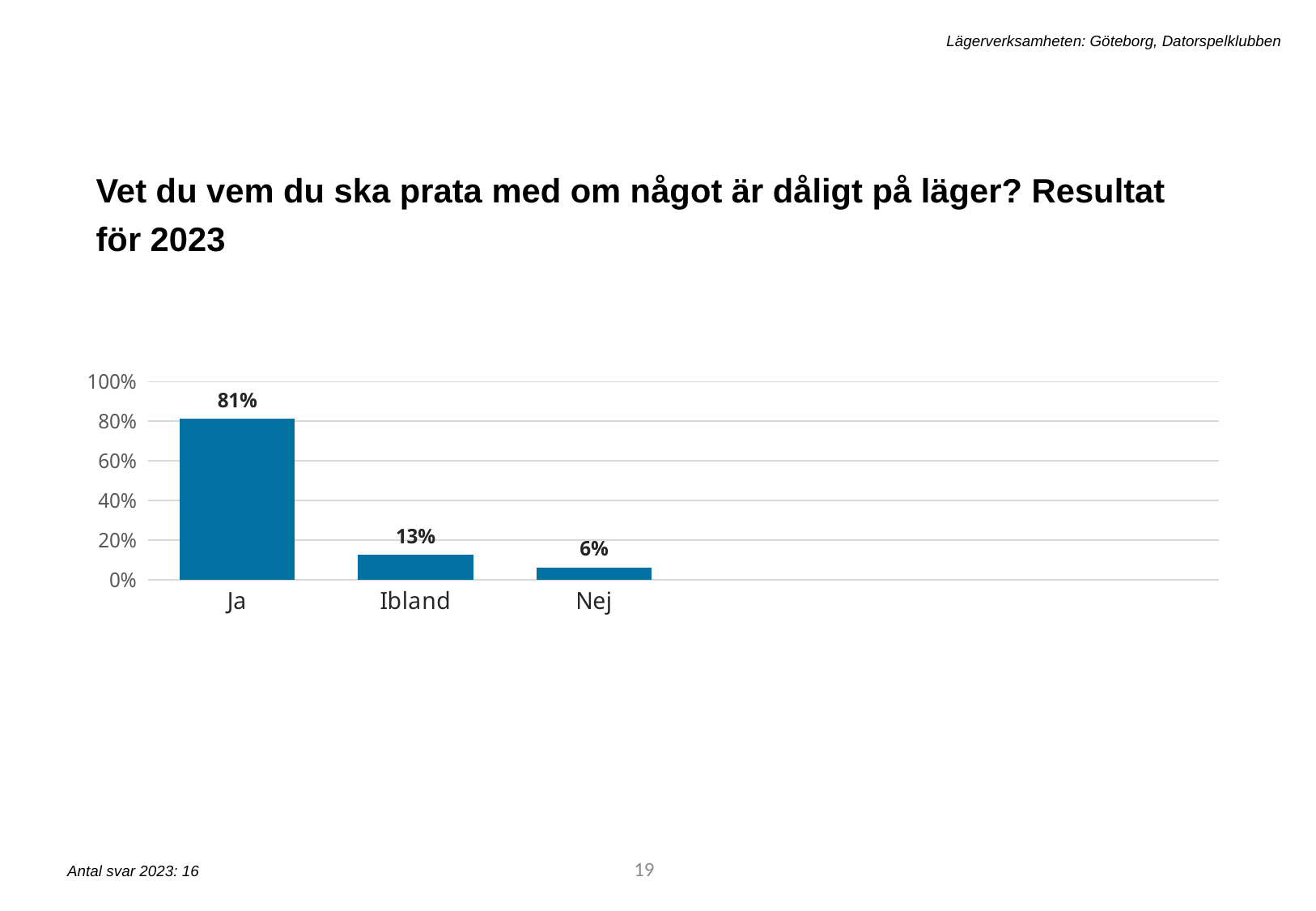
Which category has the lowest value? Nej What is the value for Nej? 6% What is the difference between the values for Ibland and Nej? 7% Which is larger, the value for Ibland or the value for Nej? Ibland How many categories are shown on the x axis? 3 What is the title of the slide? Vet du vem du ska prata med om något är dåligt på läger? Resultat för 2023 What is the value for Ibland? 13% Is the value for Ja greater or less than 60%? greater What is the difference between the values for Ja and Ibland? 68% Which category has the highest value? Ja What kind of chart is shown on the slide? bar chart What is the value for Ja? 81%